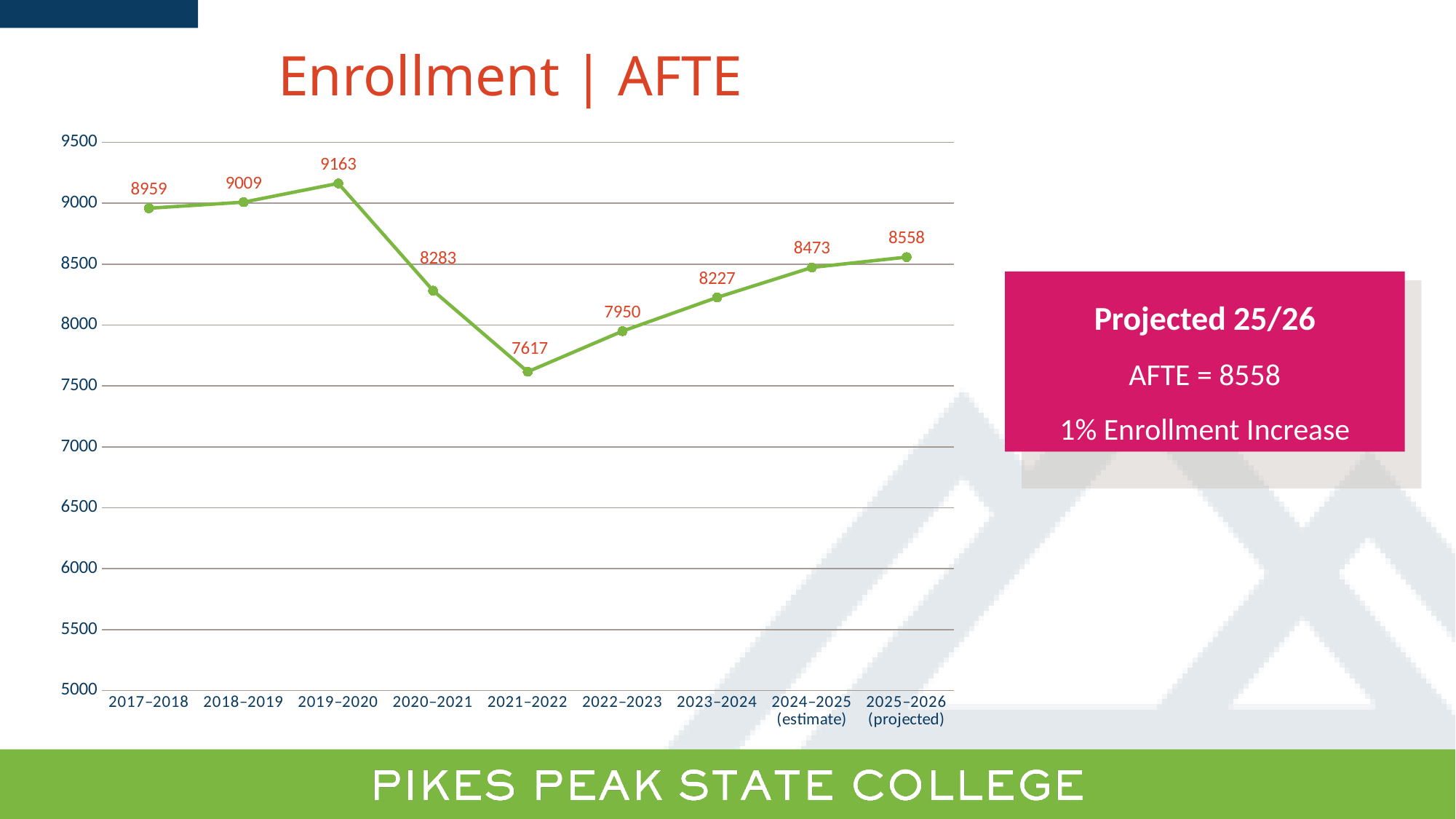
What is the difference between the AFTE values for 2019–2020 and 2021–2022? 1546 What is the difference between the AFTE values for 2024–2025 (estimate) and 2025–2026 (projected)? 85 How many academic years are plotted on the chart? 9 Do the AFTE values rise or fall from 2021–2022 to 2025–2026? rise Which academic year has the highest AFTE value? 2019–2020 Which academic year has the lowest AFTE value? 2021–2022 Which is larger, the AFTE value for 2017–2018 or for 2018–2019? 2018–2019 What is the projected AFTE value for 2025–2026? 8558 What is the AFTE value for 2021–2022? 7617 What is the AFTE value for 2019–2020? 9163 Is the AFTE value for 2022–2023 greater or less than 8000? less What kind of chart is shown on the slide? line chart